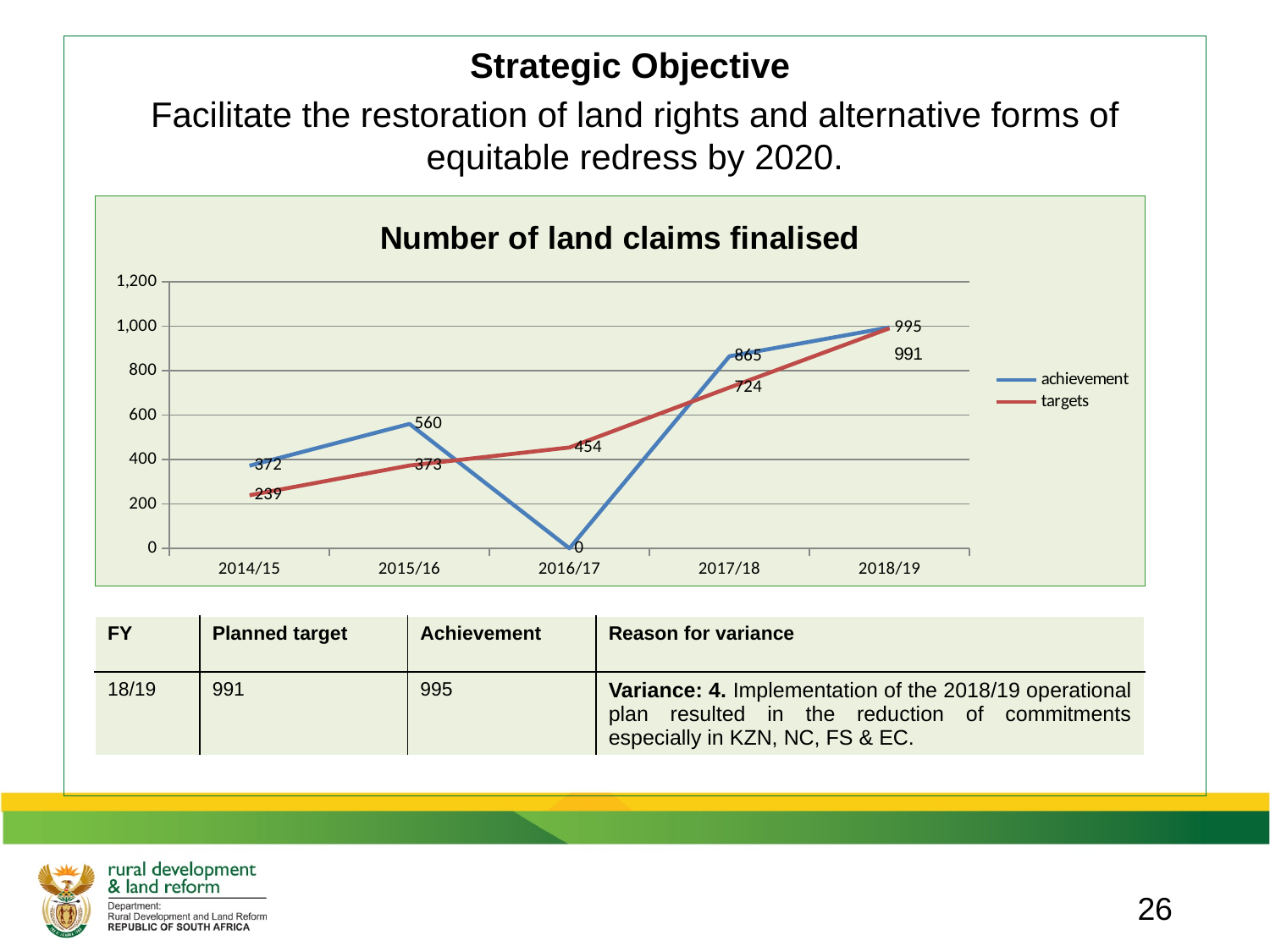
In which financial year is the targets series highest? 2018/19 In which financial year is the achievement series lowest? 2016/17 What is the difference between the achievement and targets values in 2014/15? 133 Does the targets series rise or fall from 2014/15 to 2018/19? Rise What is the achievement value for 2016/17? 0 What is the title of the chart? Number of land claims finalised What is the achievement value for 2015/16? 560 How many financial years are plotted on the x axis? 5 What is the targets value for 2017/18? 724 What type of chart is shown on the slide? Line chart Which is larger in 2016/17, the achievement value or the targets value? targets How many series does the legend list? 2